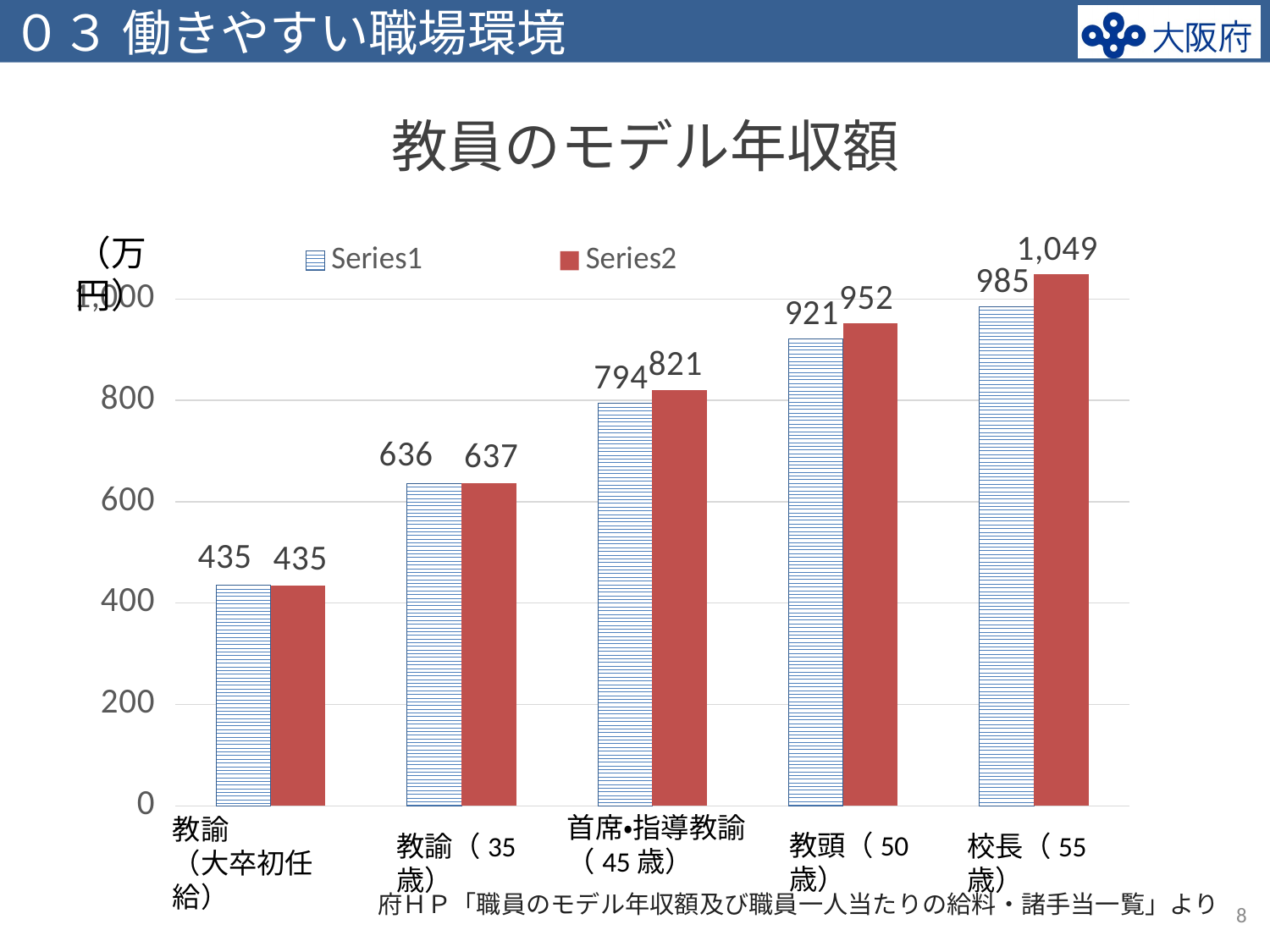
How many series does the legend list? 2 Which category has the highest Series2 value? 校長（55歳） What is the Series2 value for 校長（55歳）? 1,049 Do the Series1 values rise or fall from left to right along the x axis? rise Which category has the lowest Series1 value? 教諭（大卒初任給） What is the Series1 value for 首席・指導教諭（45歳）? 794 What is the Series2 value for 教頭（50歳）? 952 What is the title of the chart? 教員のモデル年収額 What is the difference between the Series2 and Series1 values for 校長（55歳）? 64 What type of chart is shown on the slide? bar chart Which is larger for 教頭（50歳）: the Series1 value or the Series2 value? Series2 How many categories are shown on the x axis? 5